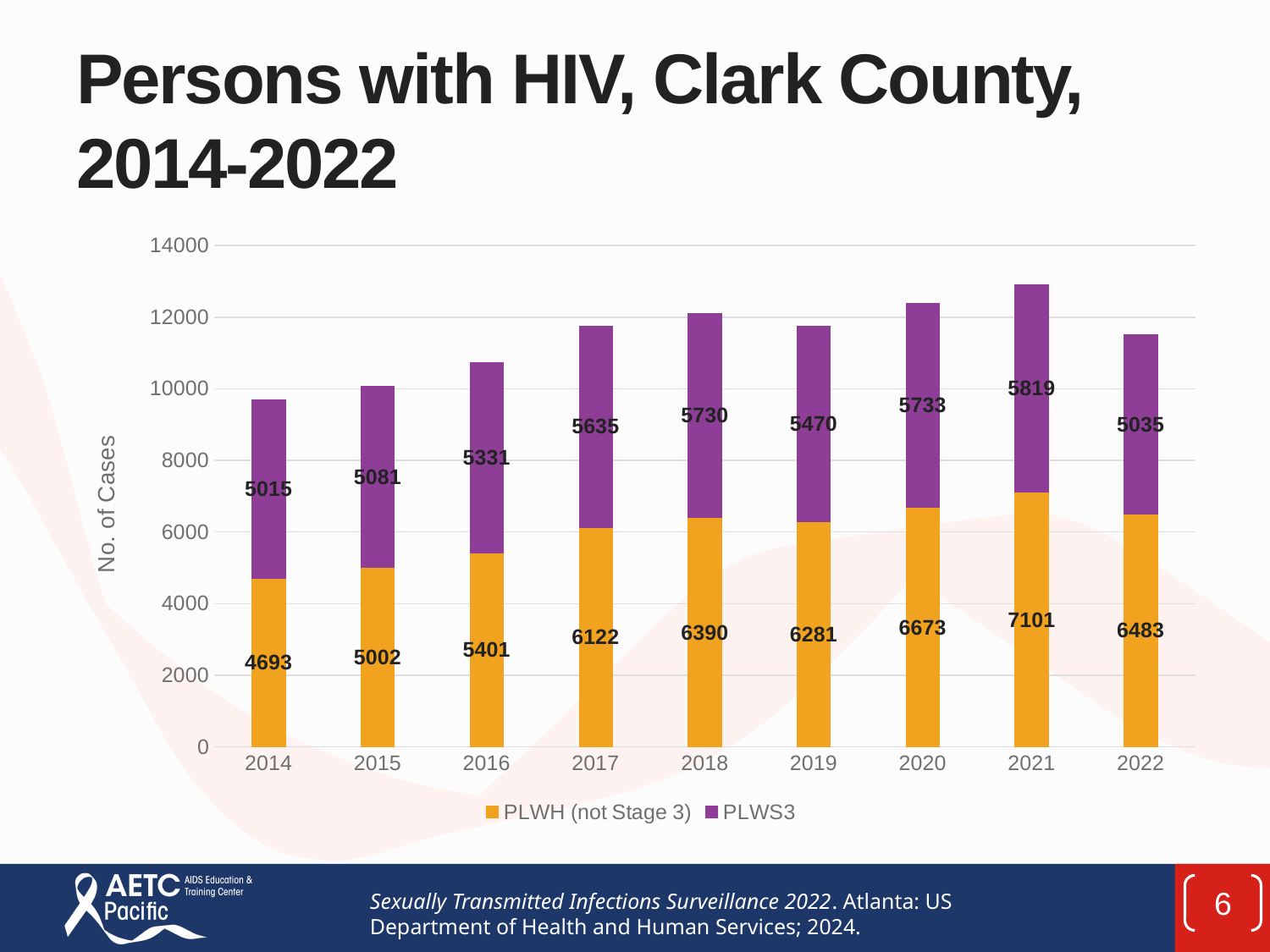
Which year has the lowest PLWS3 value? 2014 How many years are shown on the x axis? 9 What is the label of the y axis? No. of Cases How many series does the legend list? 2 Is the total stacked bar for 2014 greater or less than 10000? less Which year has the larger PLWH (not Stage 3) value, 2018 or 2019? 2018 What is the PLWS3 value for 2019? 5470 What is the difference between the PLWH (not Stage 3) values for 2021 and 2014? 2408 What is the total of the stacked bar for 2022? 11518 Which year has the highest PLWH (not Stage 3) value? 2021 What kind of chart is shown on the slide? Stacked bar chart What is the value for PLWH (not Stage 3) in 2021? 7101